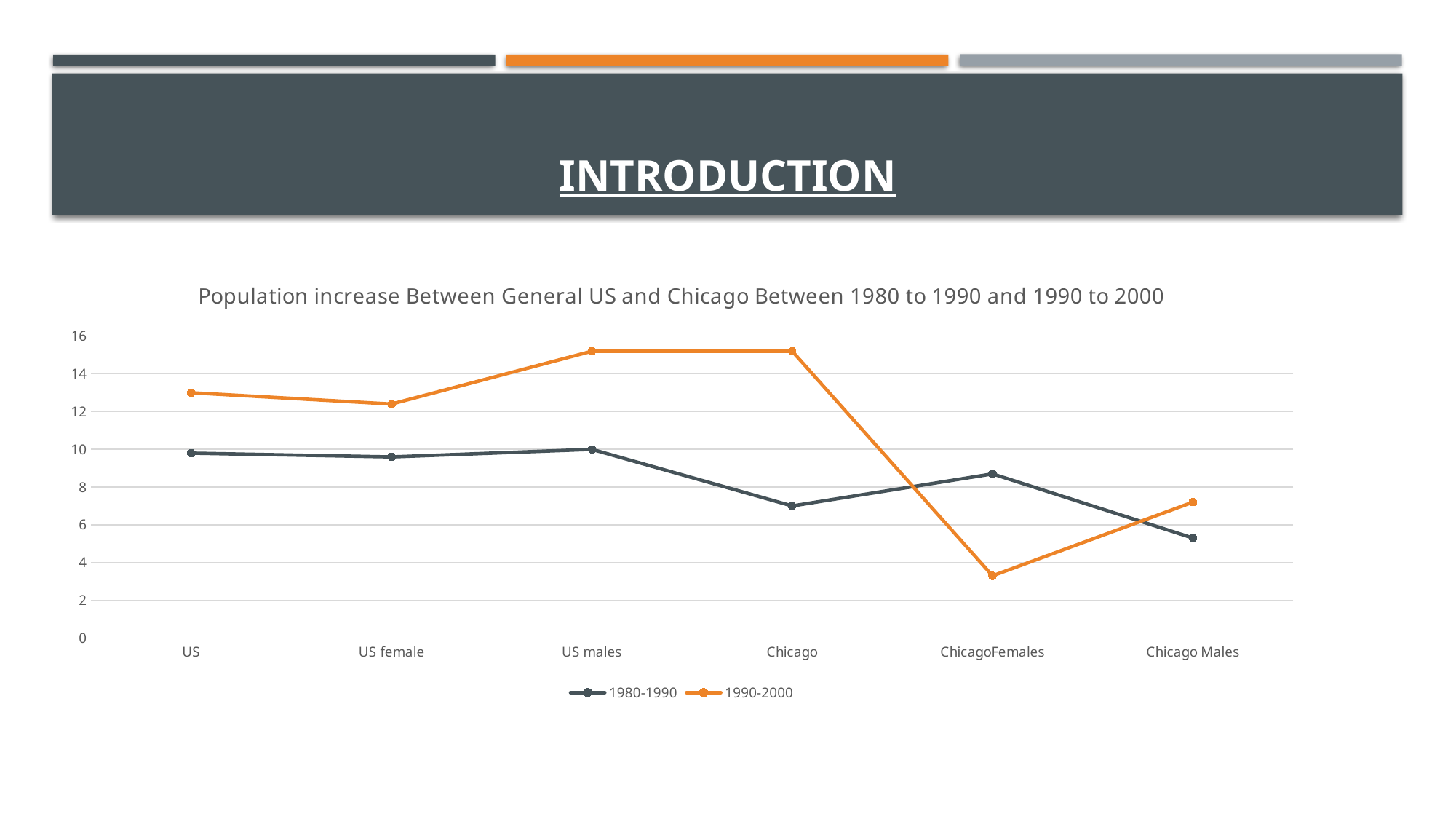
Is the value for US in the 1990-2000 series greater or less than 12? greater For ChicagoFemales, which series has the larger value, 1980-1990 or 1990-2000? 1980-1990 How many categories are shown along the x axis? 6 What kind of chart is shown on the slide? line chart Is the value for ChicagoFemales in the 1990-2000 series greater or less than 4? less How many series does the legend list? 2 What is the title of the chart? Population increase Between General US and Chicago Between 1980 to 1990 and 1990 to 2000 For Chicago, which series has the larger value, 1980-1990 or 1990-2000? 1990-2000 Which category has the lowest value for the 1990-2000 series? ChicagoFemales Does the 1990-2000 series rise or fall from Chicago to ChicagoFemales? fall Which category has the lowest value for the 1980-1990 series? Chicago Males Which series is drawn in orange? 1990-2000